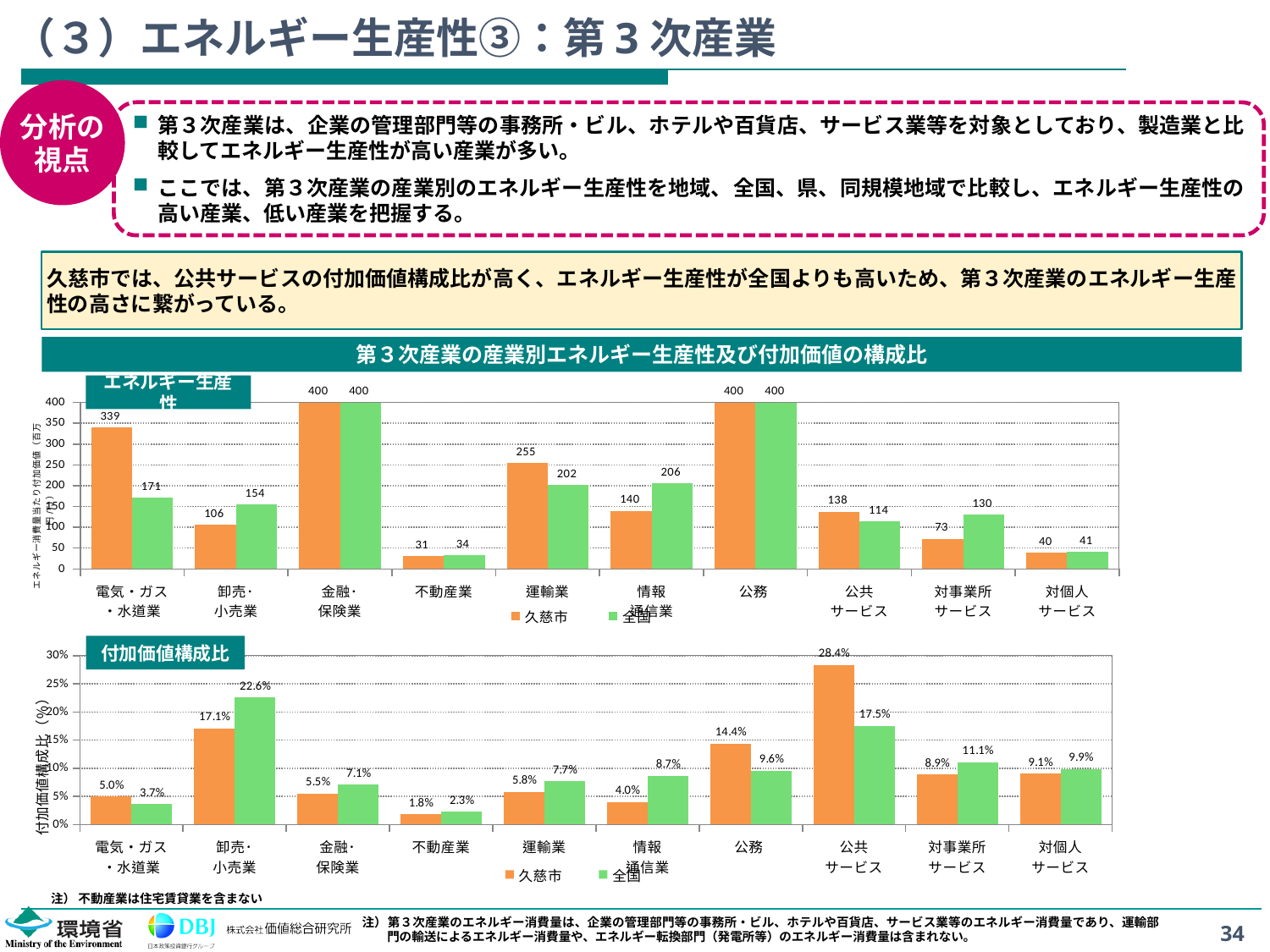
In the エネルギー生産性 chart (top), which is larger in 対事業所サービス, 久慈市 or 全国? 全国 In the 付加価値構成比 chart (bottom), what is the value for 久慈市 in 公共サービス? 28.4% How many series does the legend of the エネルギー生産性 chart (top) list? 2 In the エネルギー生産性 chart (top), which category has the lowest value for 久慈市? 不動産業 How many categories are shown on the x axis of the 付加価値構成比 chart (bottom)? 10 In the エネルギー生産性 chart (top), what is the value for 久慈市 in 電気・ガス・水道業? 339 In the 付加価値構成比 chart (bottom), which category has the highest value for 全国? 卸売・小売業 In the 付加価値構成比 chart (bottom), what is the difference between 久慈市 and 全国 in 公務? 4.8% In the 付加価値構成比 chart (bottom), which category has the lowest value for 久慈市? 不動産業 In the エネルギー生産性 chart (top), what is the difference between 久慈市 and 全国 in 運輸業? 53 In the エネルギー生産性 chart (top), what is the value for 全国 in 情報通信業? 206 What type of chart is the 付加価値構成比 chart (bottom)? Bar chart